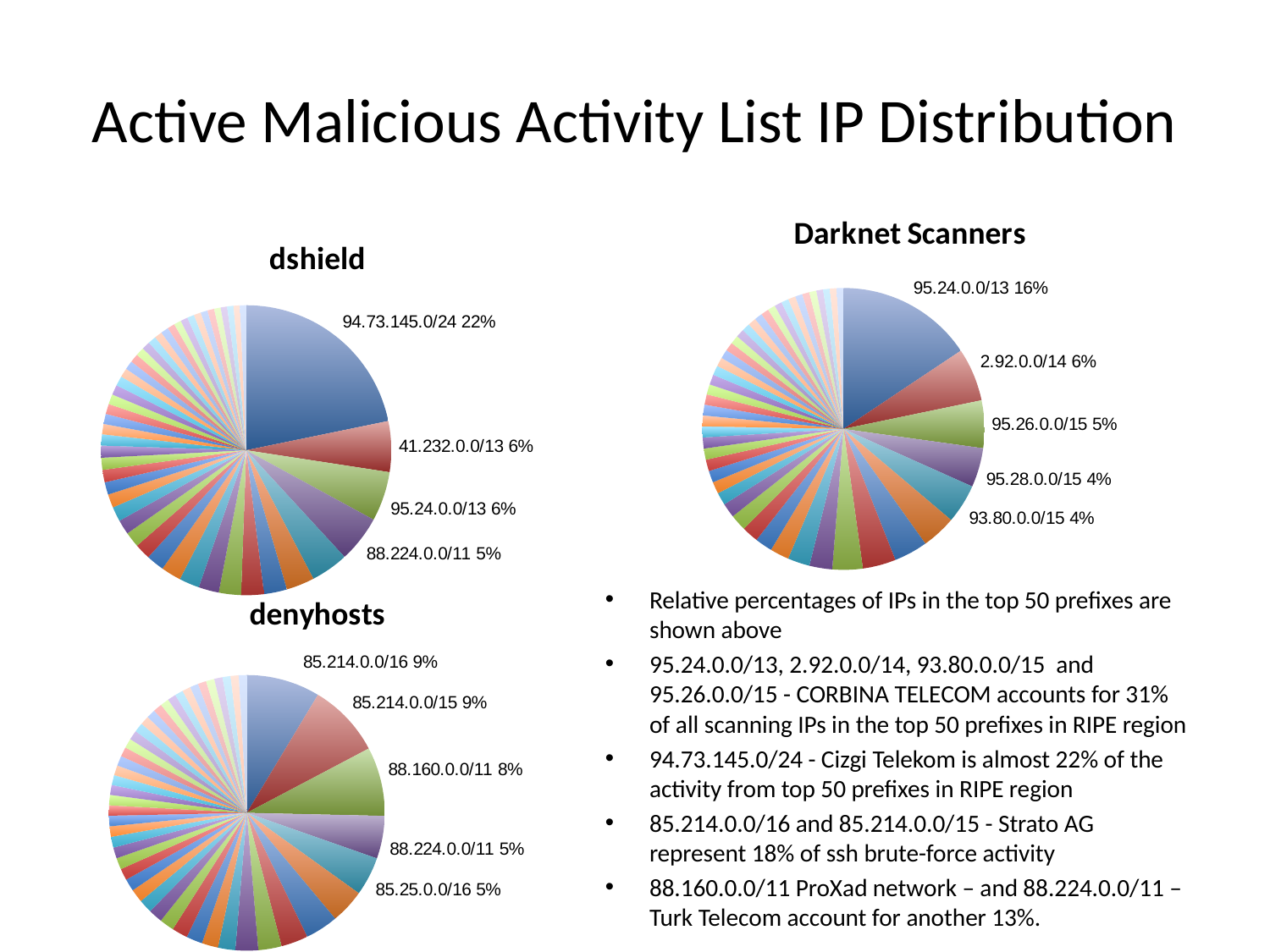
In the Darknet Scanners pie chart, which is larger: the slice for 2.92.0.0/14 or the slice for 95.28.0.0/15? 2.92.0.0/14 In the denyhosts pie chart, what is the difference between the shares of 85.214.0.0/16 and 85.25.0.0/16? 4% In the Darknet Scanners pie chart, what is the difference between the shares of 95.24.0.0/13 and 2.92.0.0/14? 10% In the Darknet Scanners pie chart, what share does 95.24.0.0/13 have? 16% In the dshield pie chart, which labelled prefix has the largest slice? 94.73.145.0/24 In the dshield pie chart, what is the difference between the shares of 94.73.145.0/24 and 41.232.0.0/13? 16% In the dshield pie chart, what share does 94.73.145.0/24 have? 22% In the Darknet Scanners pie chart, which labelled prefix has the largest slice? 95.24.0.0/13 How many pie charts are shown on the slide? 3 In the denyhosts pie chart, what share is labelled for 88.160.0.0/11? 8% What kind of chart is the denyhosts chart? Pie chart In the dshield pie chart, what share is labelled for 88.224.0.0/11? 5%